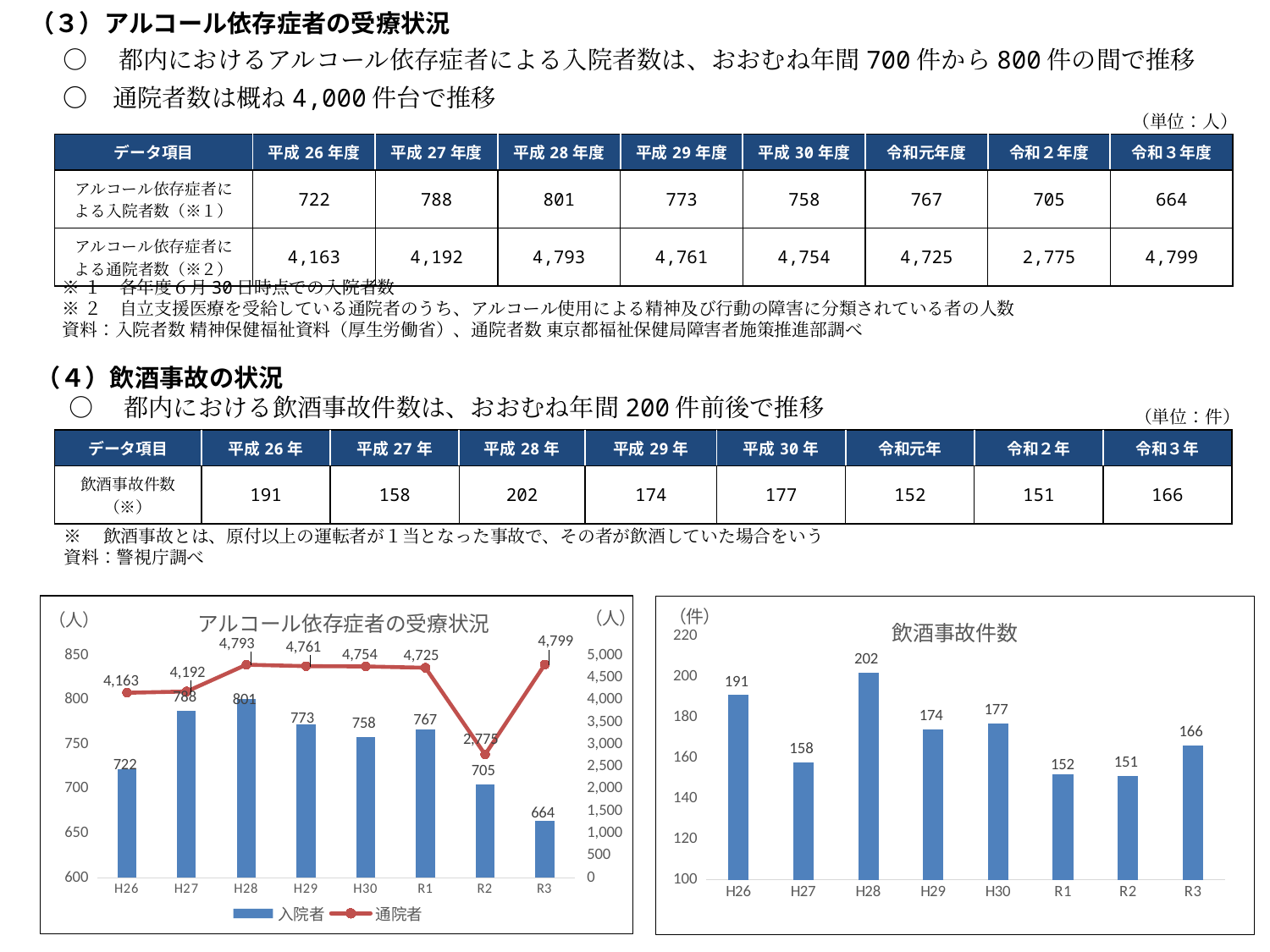
In the chart titled アルコール依存症者の受療状況, which year has the lowest 入院者 value? R3 In the chart titled 飲酒事故件数, what is the difference between the values for H26 and H27? 33 In the chart titled 飲酒事故件数, how many years are shown on the x axis? 8 In the chart titled 飲酒事故件数, which year has the highest value? H28 In the chart titled アルコール依存症者の受療状況, what is the 通院者 value for R2? 2,775 In the chart titled アルコール依存症者の受療状況, which year has the highest 通院者 value? R3 In the chart titled 飲酒事故件数, which year has the lowest value? R2 In the chart titled 飲酒事故件数, what kind of chart is it? Bar chart In the chart titled アルコール依存症者の受療状況, is the 入院者 value for H27 larger or smaller than the value for H29? Larger In the chart titled アルコール依存症者の受療状況, what is the 入院者 value for H28? 801 In the chart titled アルコール依存症者の受療状況, how many series does the legend list? 2 In the chart titled 飲酒事故件数, what is the value for H28? 202